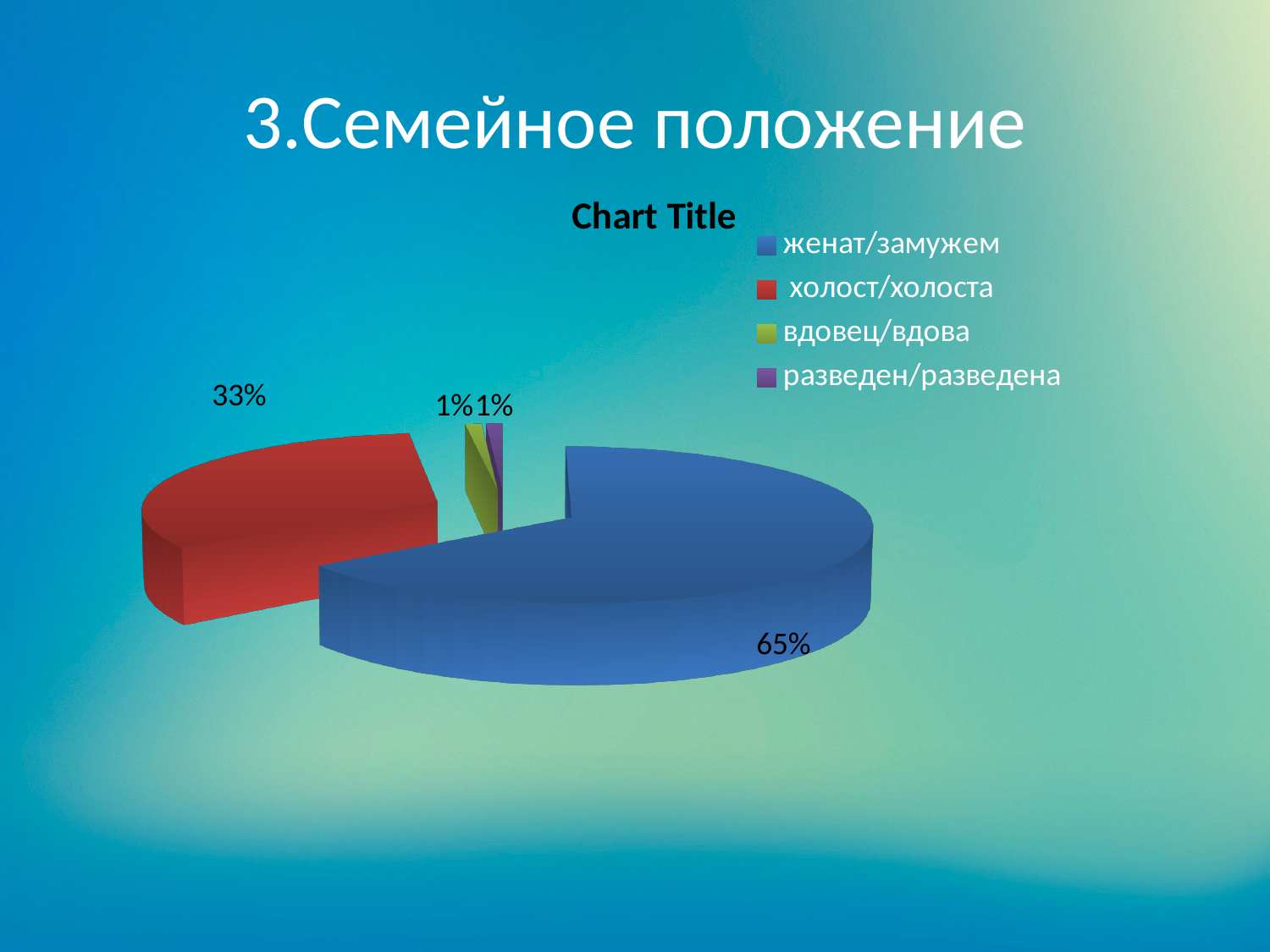
What is the title shown above the chart? Chart Title Which category has the largest slice of the pie? женат/замужем How many categories does the legend list? 4 Which is larger, the slice for холост/холоста or the slice for вдовец/вдова? холост/холоста What is the difference in percentage points between женат/замужем and холост/холоста? 32 What share of the pie does женат/замужем have? 65% What share of the pie does разведен/разведена have? 1% What kind of chart is shown on the slide? pie chart What share of the pie does вдовец/вдова have? 1% What colour is the slice for холост/холоста? red